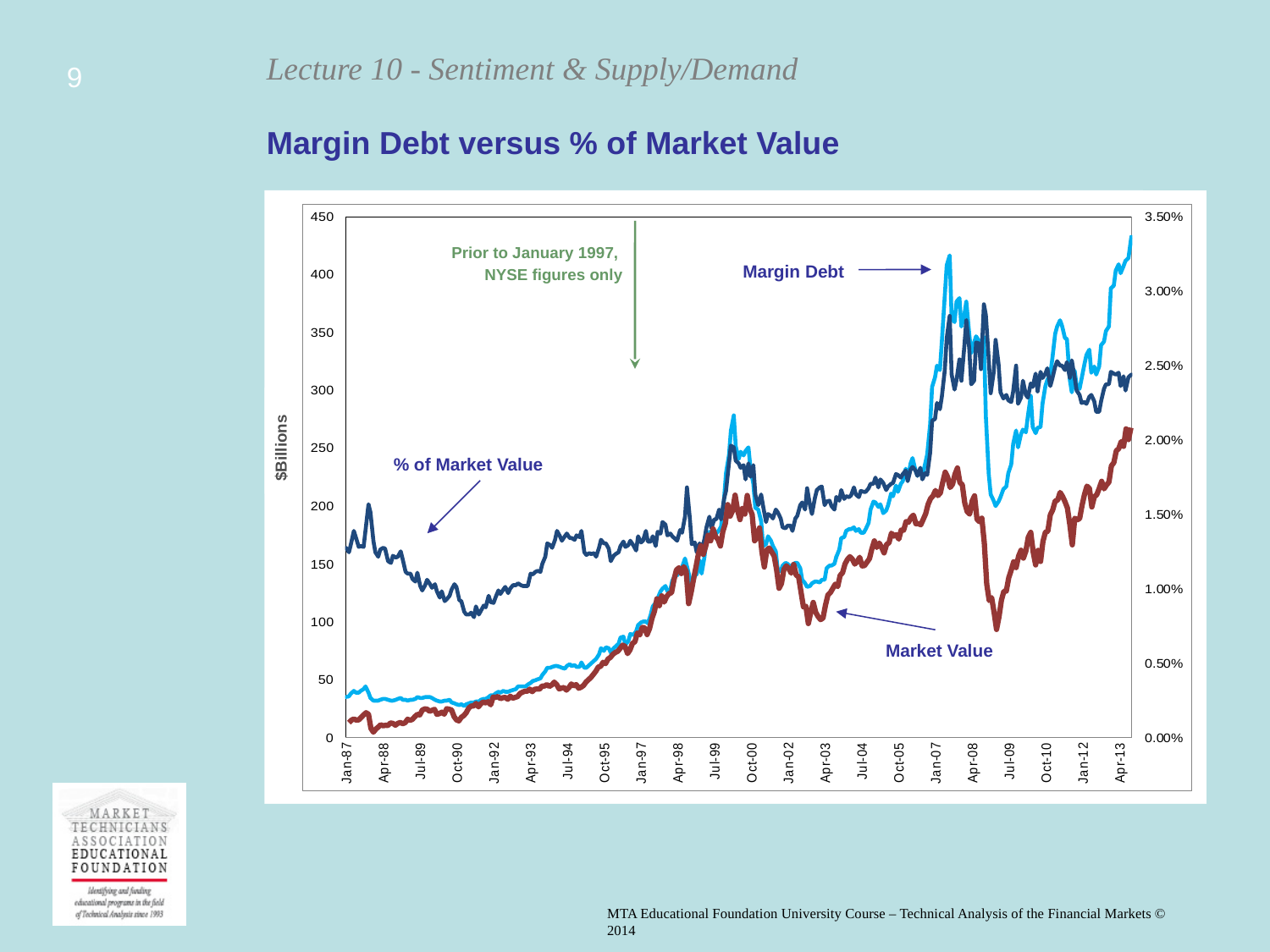
Does the Margin Debt series rise or fall from Jan-87 to Jul-99? rise Is the Margin Debt value at Jan-87 greater or less than 100 on the left axis? less Is the Market Value at Jan-87 greater or less than 50 on the left axis? less How many data series are plotted on the chart? 3 What is the label on the left vertical axis of the chart? $Billions Is the % of Market Value at Oct-90 greater or less than 1.00% on the right axis? less What kind of chart is shown on the slide? line chart What is the title of the chart? Margin Debt versus % of Market Value Does the Market Value series overall rise or fall from Jan-87 to Apr-13? rise